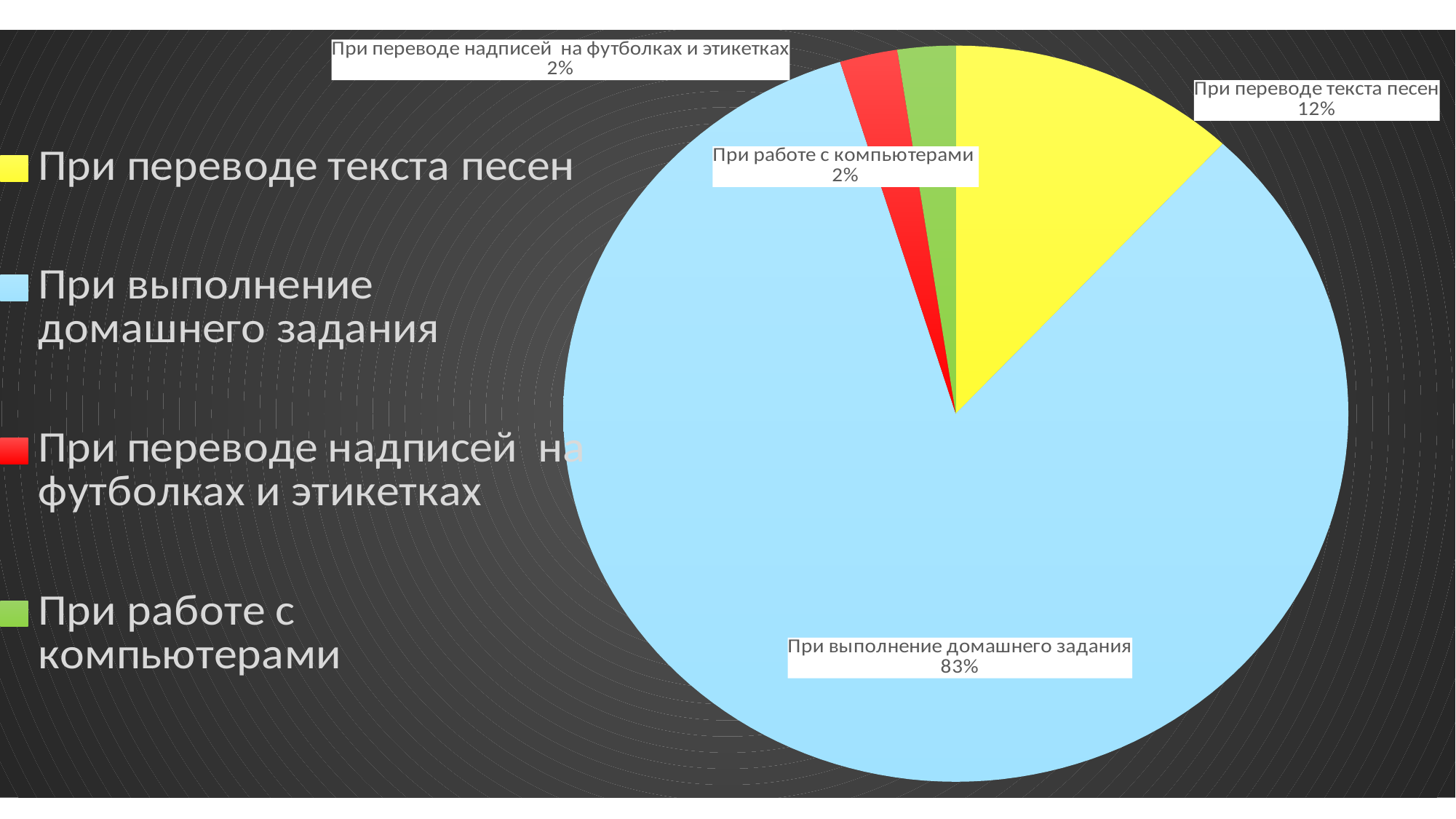
What colour is the slice for "При выполнение домашнего задания"? Light blue What percentage is shown for "При переводе текста песен"? 12% How many entries does the legend list? 4 What percentage is shown for "При переводе надписей на футболках и этикетках"? 2% What is the difference in percentage points between "При выполнение домашнего задания" and "При переводе текста песен"? 71 percentage points Which category has the largest slice of the pie? При выполнение домашнего задания What colour is the slice for "При переводе текста песен"? Yellow What percentage is shown for "При работе с компьютерами"? 2% What share of the pie does "При выполнение домашнего задания" have? 83% Which is larger: the slice for "При переводе текста песен" or the slice for "При работе с компьютерами"? При переводе текста песен What kind of chart is shown on the slide? Pie chart How many slices does the pie chart have? 4